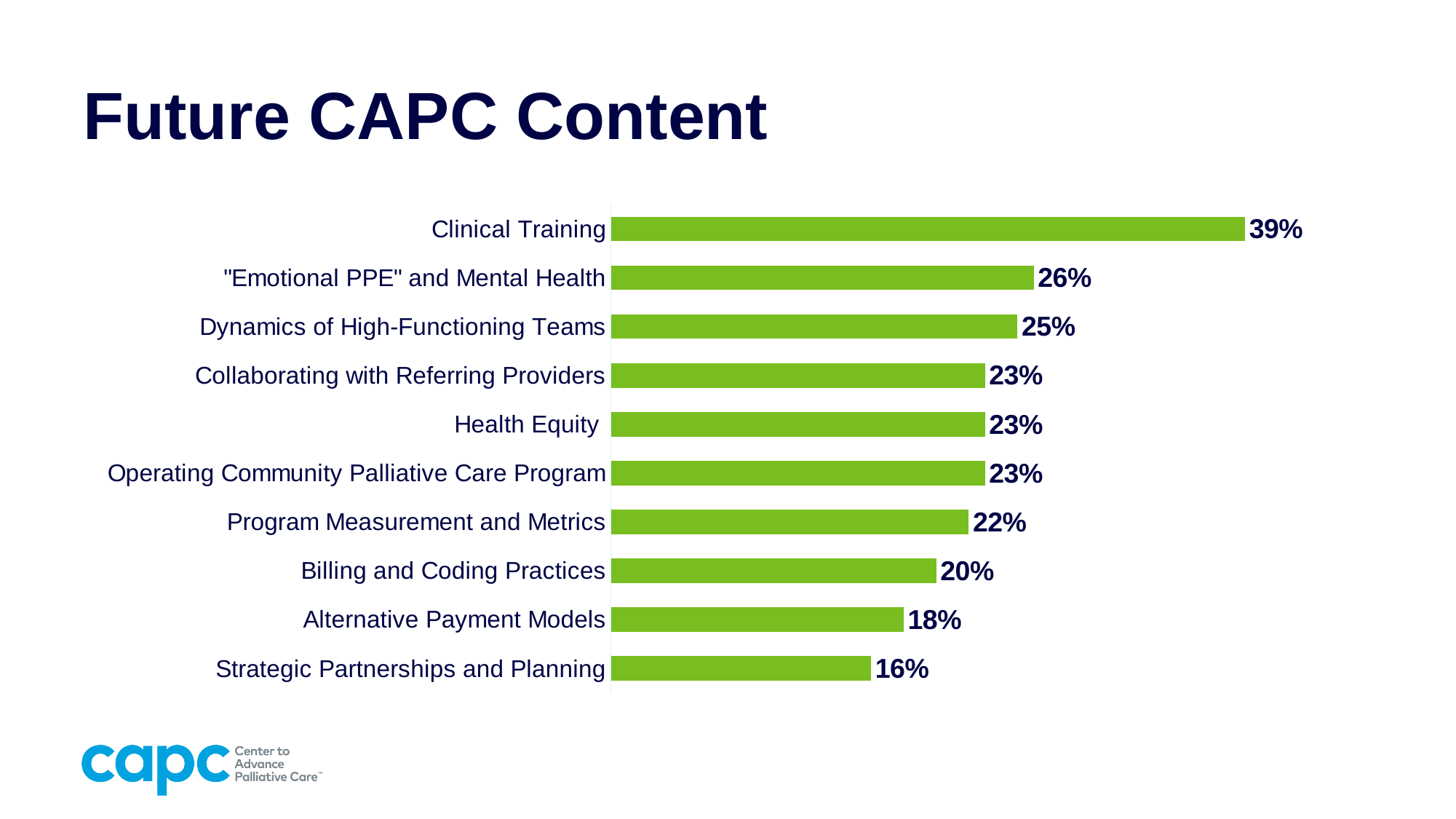
What is the value for Clinical Training? 39% What is the value for Health Equity? 23% What is the difference between the values for Alternative Payment Models and Strategic Partnerships and Planning? 2% What kind of chart is shown on the slide? Bar chart What is the difference between the values for Clinical Training and "Emotional PPE" and Mental Health? 13% Which category has the lowest value? Strategic Partnerships and Planning How many categories have a value of 23%? 3 What is the value for Billing and Coding Practices? 20% Which is larger, the value for Dynamics of High-Functioning Teams or the value for Program Measurement and Metrics? Dynamics of High-Functioning Teams What is the title of the slide? Future CAPC Content Which category has the highest value? Clinical Training How many categories are shown in the chart? 10